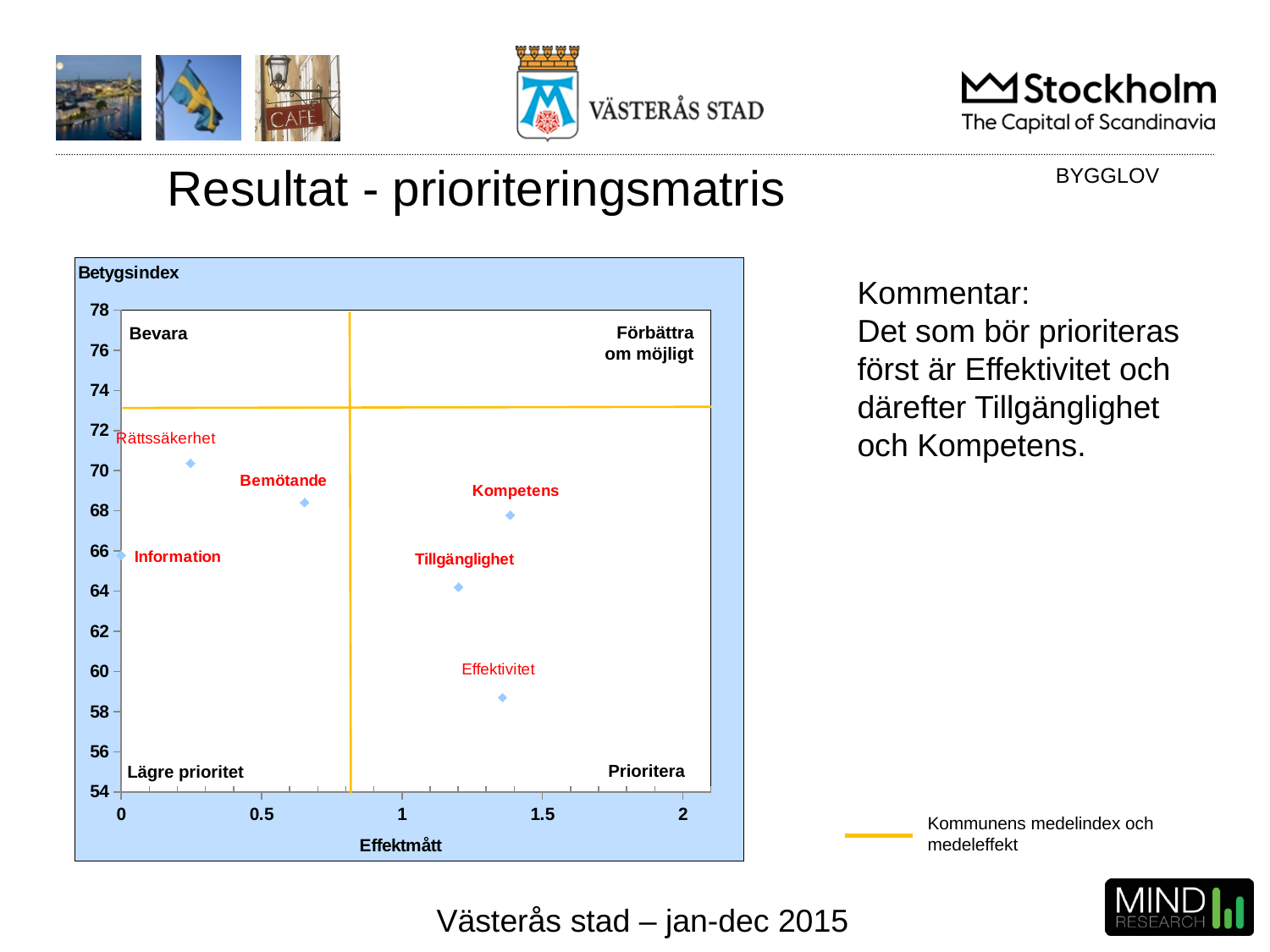
Is the Betygsindex for Effektivitet greater or less than 60? less What is the label of the horizontal axis of the chart? Effektmått What kind of chart is shown on the slide? scatter chart Which point has the lowest Betygsindex? Effektivitet Which point has the highest Betygsindex? Rättssäkerhet Is the Effektmått for Kompetens greater or less than 1? greater Is the Betygsindex for Rättssäkerhet greater or less than 68? greater Which point has the lowest Effektmått? Information Which has a higher Betygsindex, Kompetens or Tillgänglighet? Kompetens How many data points are plotted in the chart? 6 Which has a higher Effektmått, Rättssäkerhet or Bemötande? Bemötande